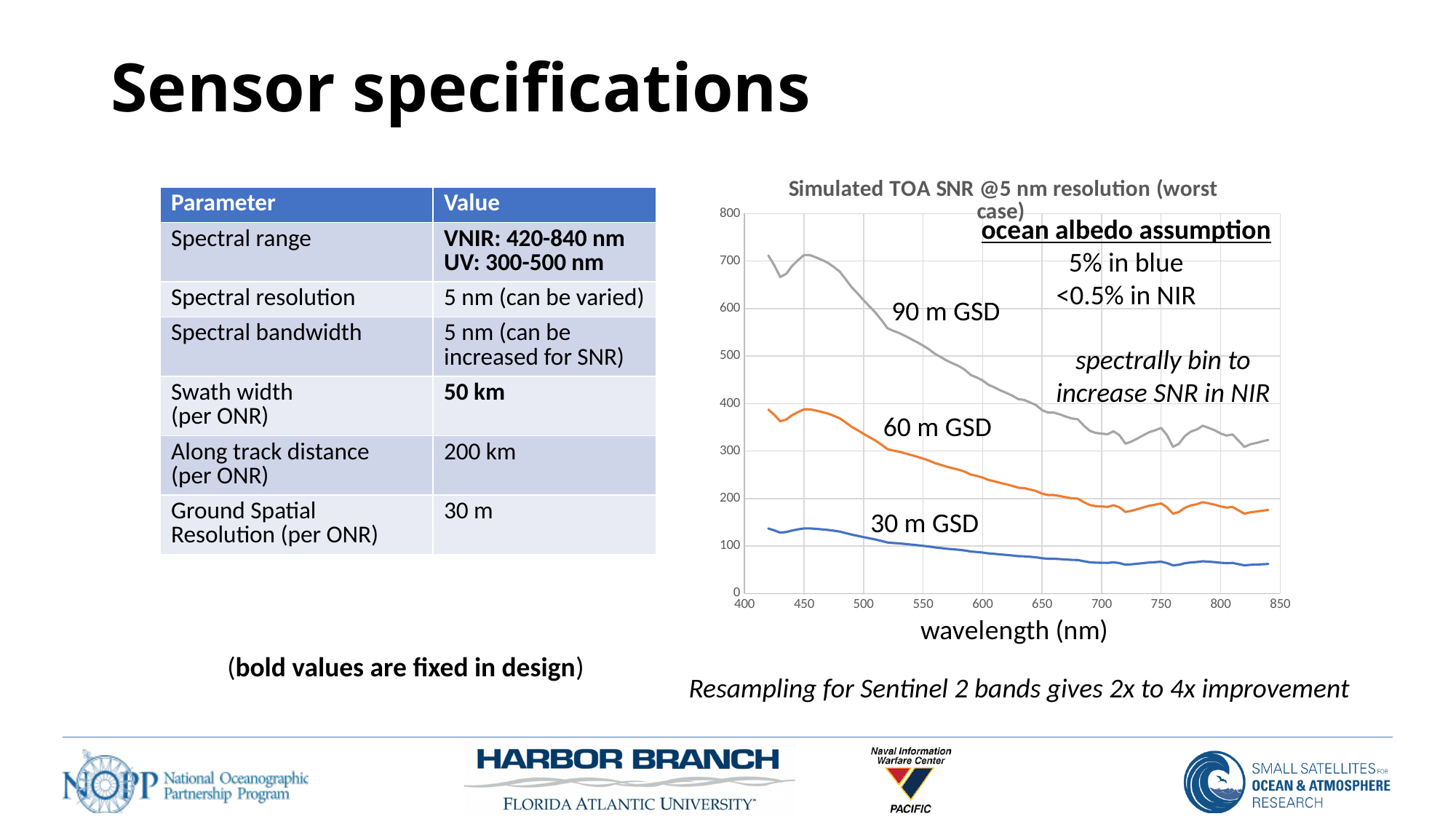
Is the value for 30 m GSD at 700 nm greater or less than 100? less How many lines (series) are plotted on the chart? 3 Which series has the highest SNR values across the wavelength range? 90 m GSD What is the label of the x axis of the chart? wavelength (nm) Which series has the lowest SNR values across the wavelength range? 30 m GSD What is the title of the chart? Simulated TOA SNR @5 nm resolution (worst case) Is the value for 90 m GSD at 700 nm greater or less than 400? less What kind of chart is shown on the slide? line chart At 500 nm, which series has the larger SNR, 90 m GSD or 30 m GSD? 90 m GSD Is the value for 60 m GSD at 600 nm greater or less than 200? greater Do the SNR values for the 90 m GSD series generally rise or fall as wavelength increases from 450 nm to 700 nm? fall